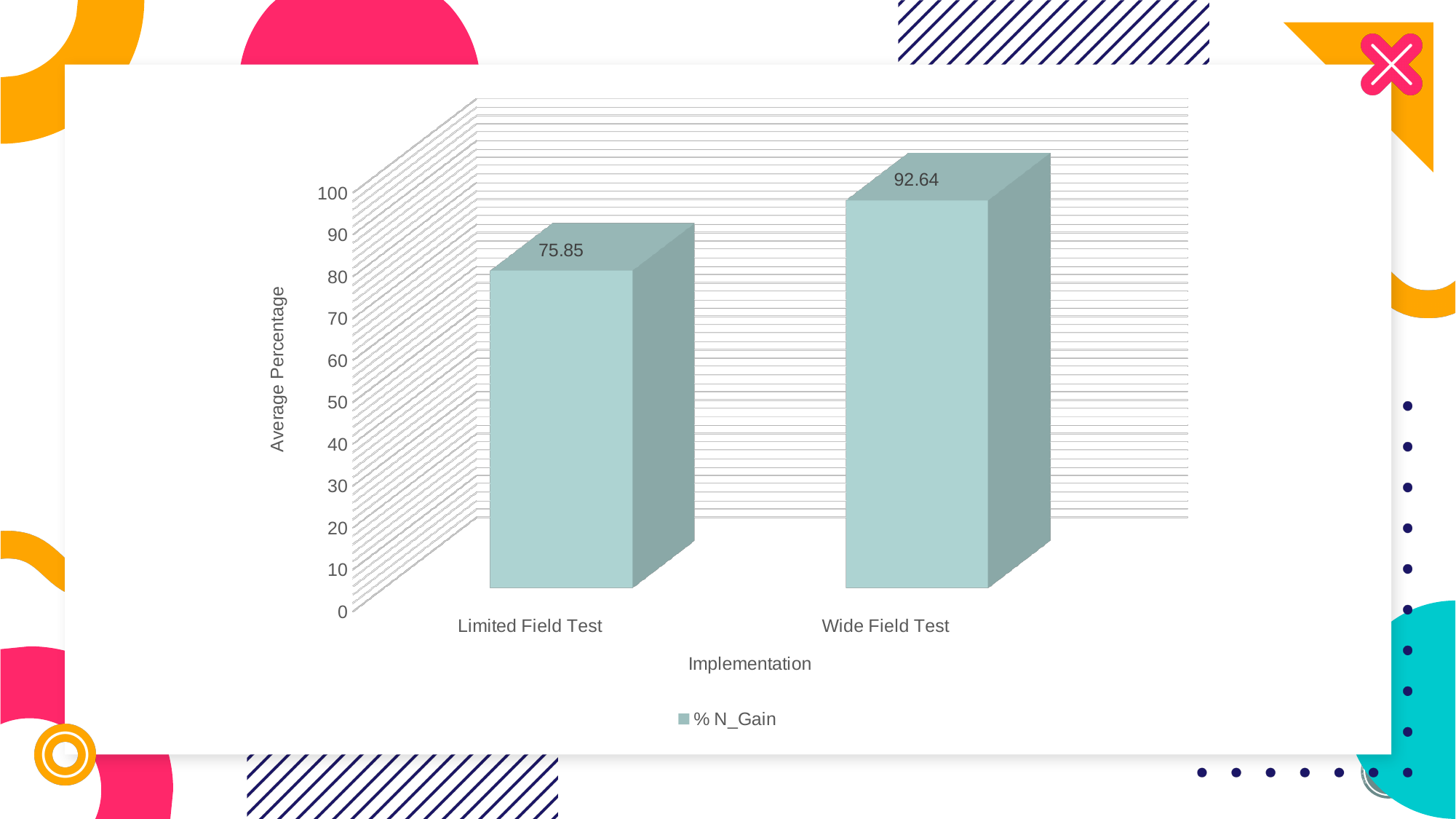
What is the difference in % N_Gain between Wide Field Test and Limited Field Test? 16.79 What is the label of the vertical axis? Average Percentage How many series does the legend list? 1 How many implementation categories are shown on the x axis? 2 Which implementation has the higher % N_Gain? Wide Field Test What is the % N_Gain value for Wide Field Test? 92.64 Which implementation has the lower % N_Gain? Limited Field Test What is the % N_Gain value for Limited Field Test? 75.85 What series name is shown in the legend? % N_Gain Is the % N_Gain for Wide Field Test greater or less than 90? greater What kind of chart is shown on the slide? Bar chart Is the % N_Gain for Limited Field Test greater or less than 80? less